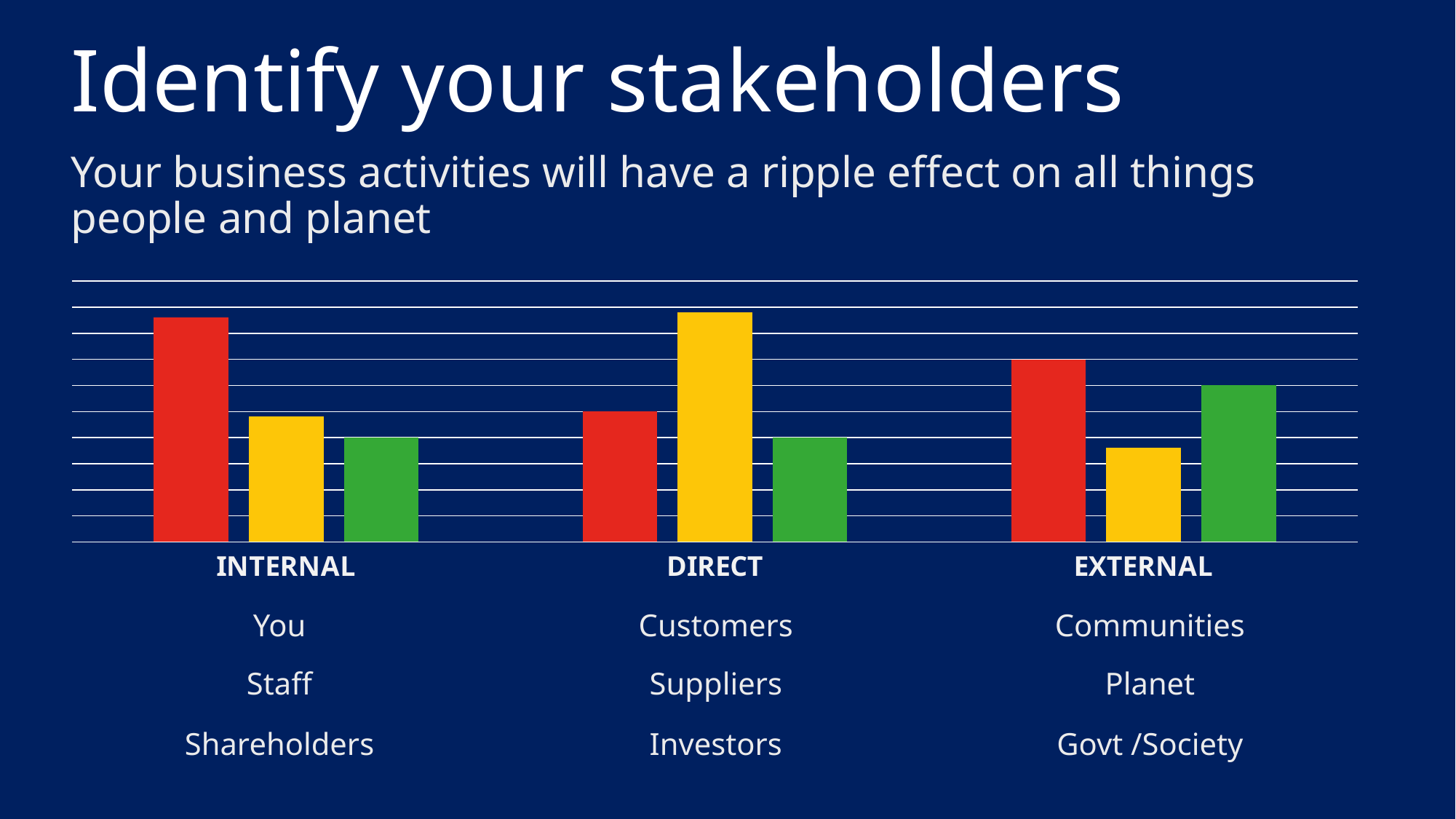
Is the green bar taller in the INTERNAL category or in the EXTERNAL category? EXTERNAL Which coloured bar is the tallest in the INTERNAL category? Red Which coloured bar is the shortest in the INTERNAL category? Green Which coloured bar is the tallest in the EXTERNAL category? Red Which coloured bar is the tallest in the DIRECT category? Yellow Which coloured bar is the shortest in the EXTERNAL category? Yellow What kind of chart is shown on the slide? Bar chart How many categories are shown along the x axis of the chart? 3 What three colours are used for the bars in the chart? Red, yellow and green Is the red bar taller in the INTERNAL category or in the DIRECT category? INTERNAL Which three stakeholder groups are listed under the DIRECT category? Customers, Suppliers, Investors How many bars are plotted in each category of the chart? 3